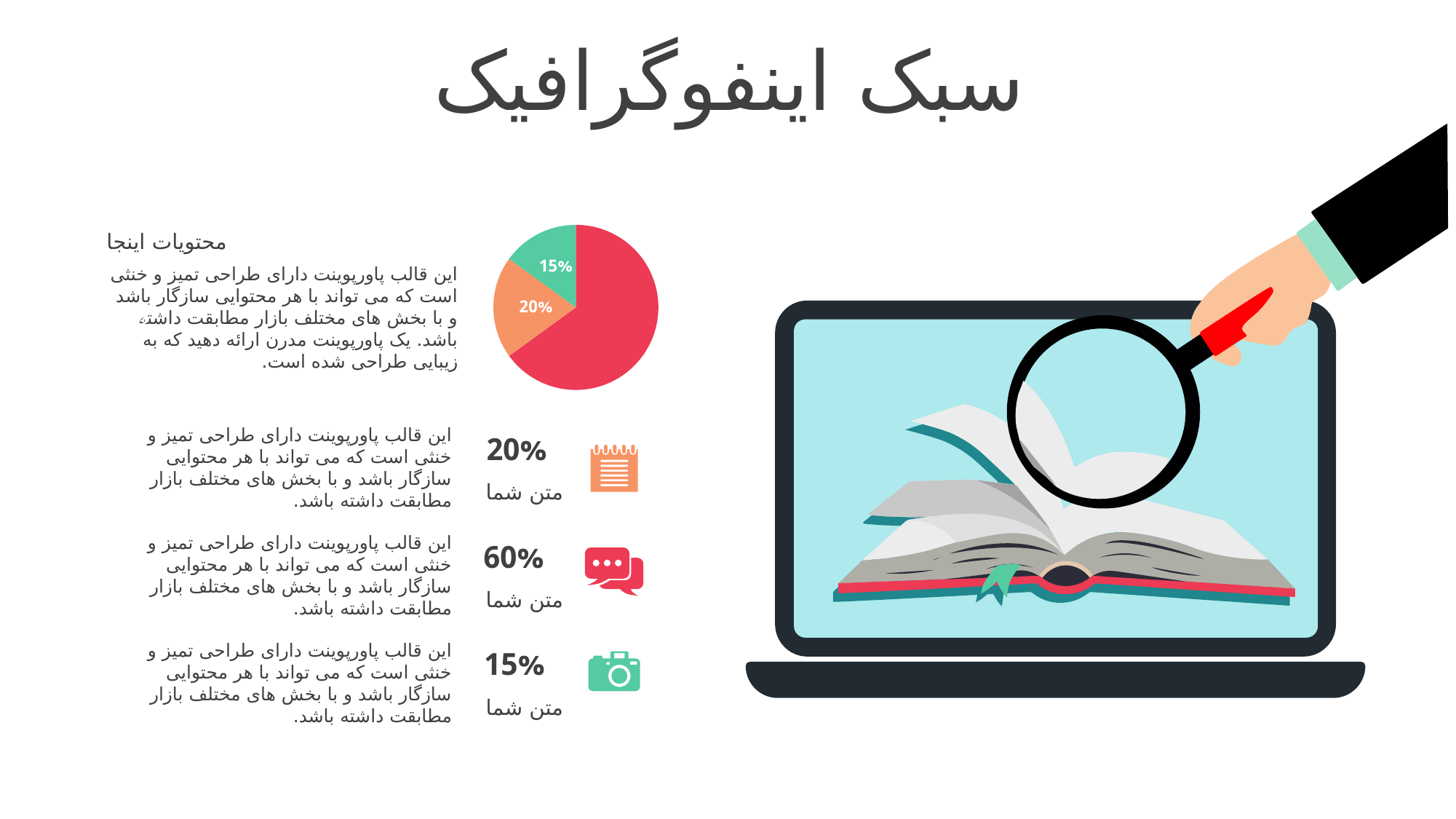
Which is larger in the pie chart, the orange slice or the green slice? the orange slice Which slice of the pie chart is the largest? the red slice What value is printed on the orange slice of the pie chart? 20% What colour is the slice labelled 15% in the pie chart? green What is the difference between the orange slice (20%) and the green slice (15%) in the pie chart? 5 percentage points What kind of chart is shown on the slide? pie chart How many slices does the pie chart have? 3 What value is printed on the green slice of the pie chart? 15% Which slice of the pie chart is the smallest? the green slice (15%) What colour is the slice labelled 20% in the pie chart? orange